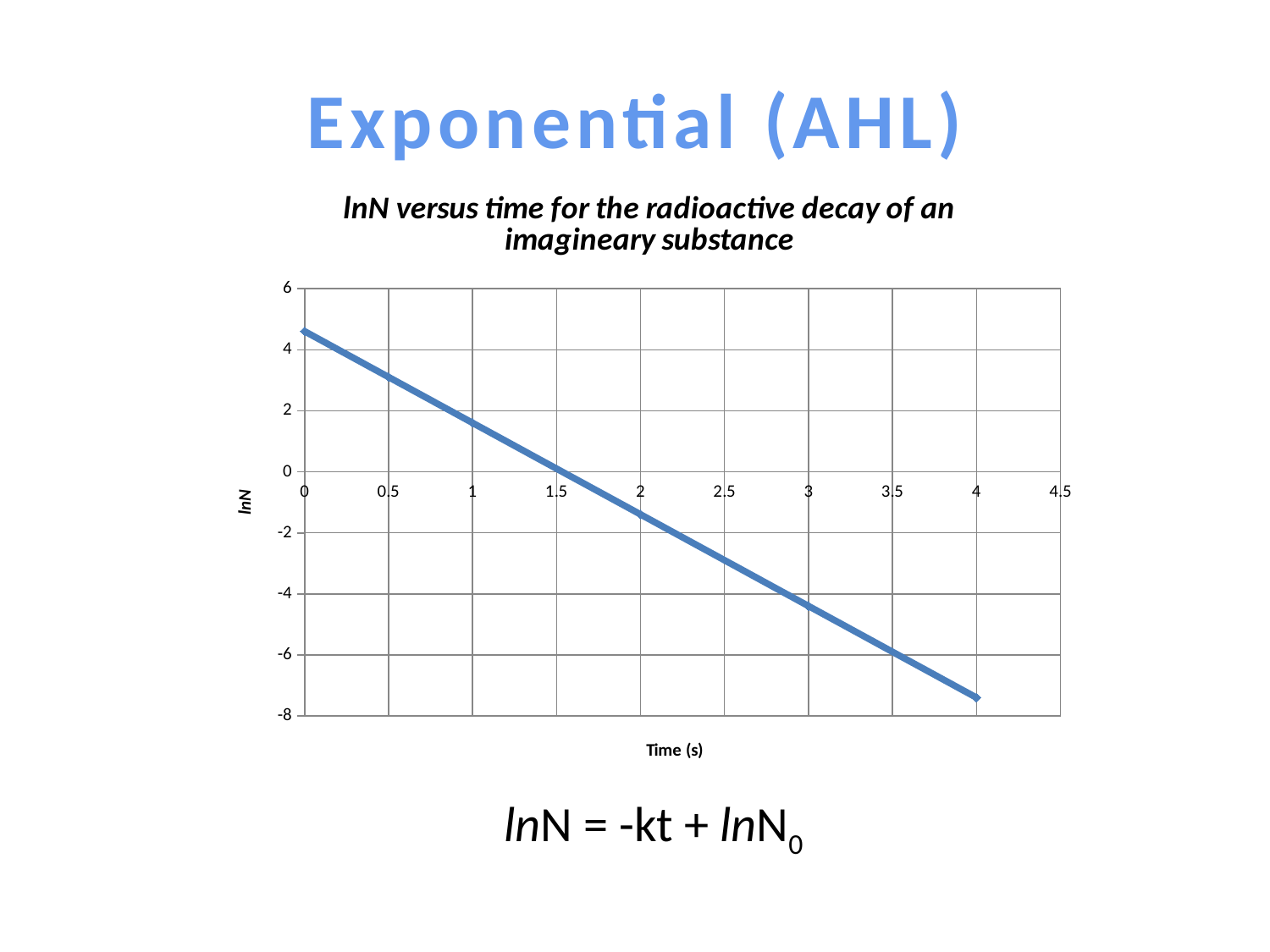
Is the value of lnN at time 1 s greater or less than 0? greater Is the value of lnN at time 3 s greater or less than -2? less What type of chart is shown on the slide? line chart At which time is lnN highest on the plotted line? 0 Which is larger, the value of lnN at time 1 s or at time 3 s? time 1 s Is the value of lnN at time 0 s greater or less than 4? greater At which time is lnN lowest on the plotted line? 4 Does lnN rise or fall as time increases along the x axis? fall What is the title of the chart? lnN versus time for the radioactive decay of an imagineary substance What is the label of the x axis? Time (s)